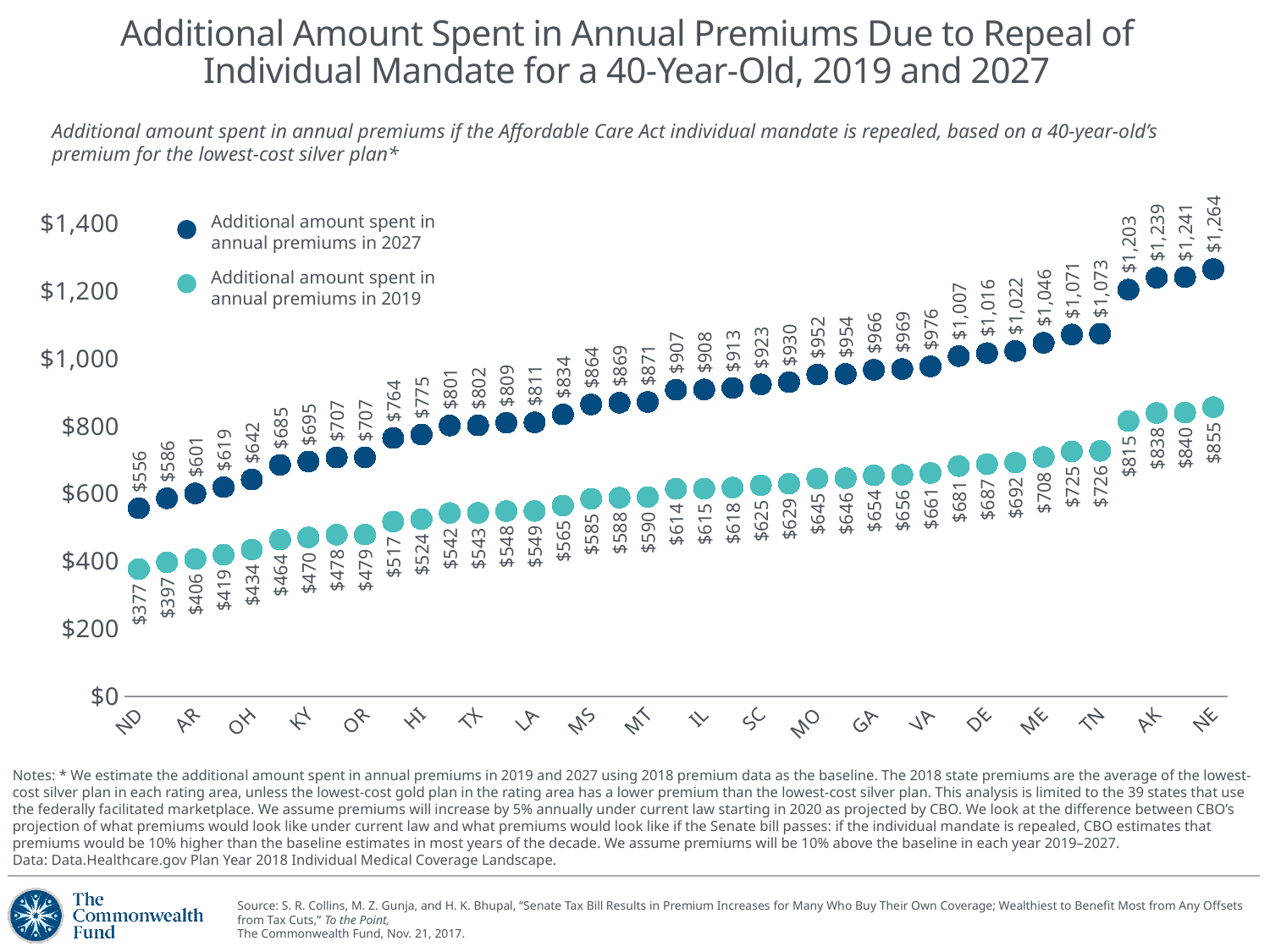
What is the additional amount spent in annual premiums in 2027 for NE? $1,264 How many series does the legend list? 2 What is the additional amount spent in annual premiums in 2019 for ND? $377 For ND, what is the difference between the 2027 and 2019 additional amounts? $179 Which state has the lowest additional amount spent in annual premiums in 2019? ND Do the values rise or fall from left to right along the x axis? rise Which state has the highest additional amount spent in annual premiums in 2027? NE Which is larger: the 2027 additional amount for NE or for ND? NE What is the additional amount spent in annual premiums in 2027 for ND? $556 Is the 2027 additional amount for ND greater or less than $600? less What is the additional amount spent in annual premiums in 2019 for NE? $855 For NE, how much larger is the 2027 additional amount than the 2019 additional amount? $409